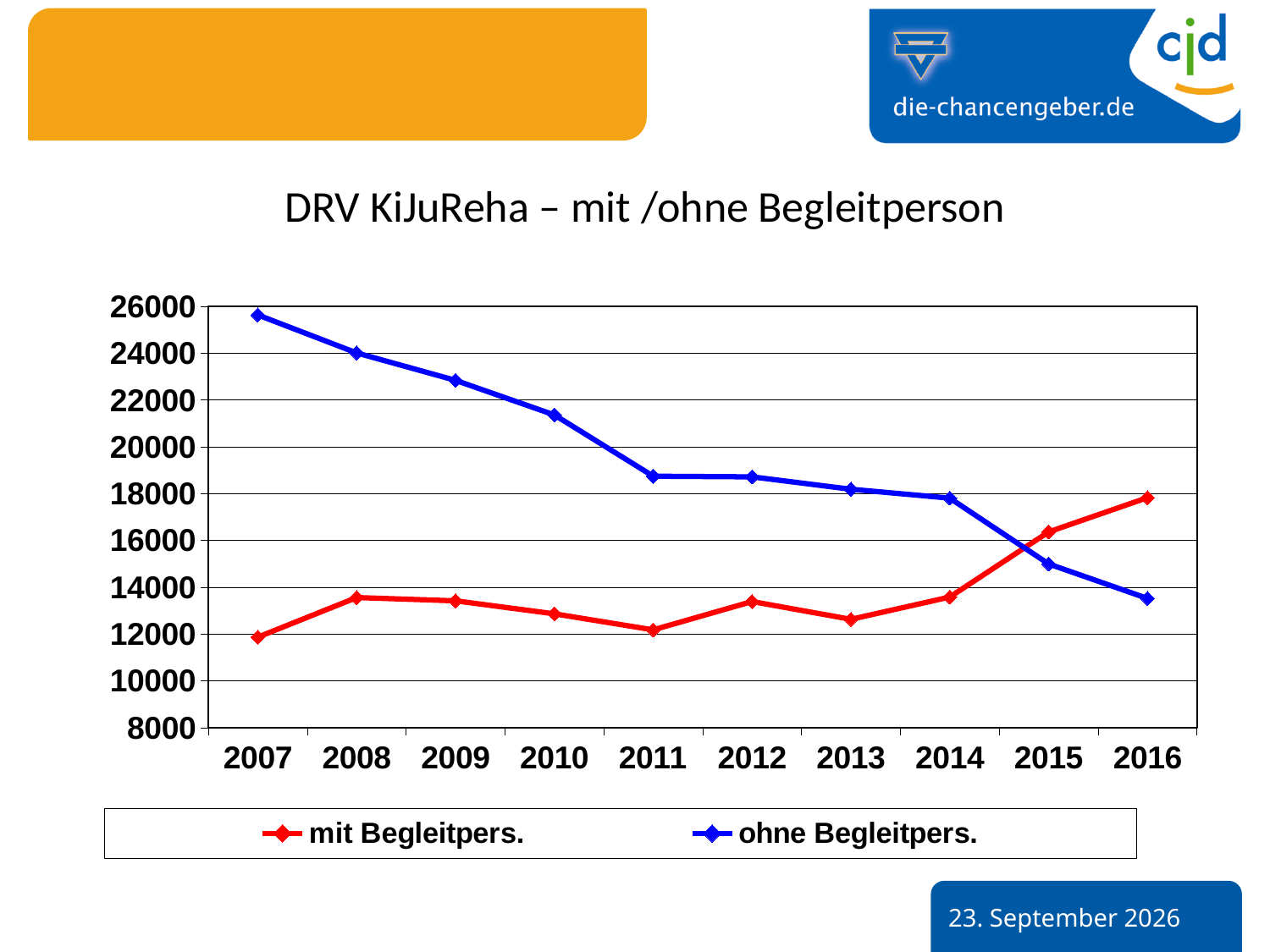
What is the title of the chart? DRV KiJuReha – mit /ohne Begleitperson In 2016, which series has the larger value, 'mit Begleitpers.' or 'ohne Begleitpers.'? mit Begleitpers. How many years are plotted along the x axis? 10 In which year is the value for 'ohne Begleitpers.' lowest? 2016 Which series is drawn in blue? ohne Begleitpers. In which year is the value for 'ohne Begleitpers.' highest? 2007 How many series does the legend list? 2 Is the value for 'ohne Begleitpers.' in 2016 greater or less than 14000? less Is the value for 'ohne Begleitpers.' in 2007 greater or less than 24000? greater What kind of chart is shown on the slide? line chart In which year is the value for 'mit Begleitpers.' highest? 2016 Does the value for 'ohne Begleitpers.' rise or fall from 2007 to 2016? fall